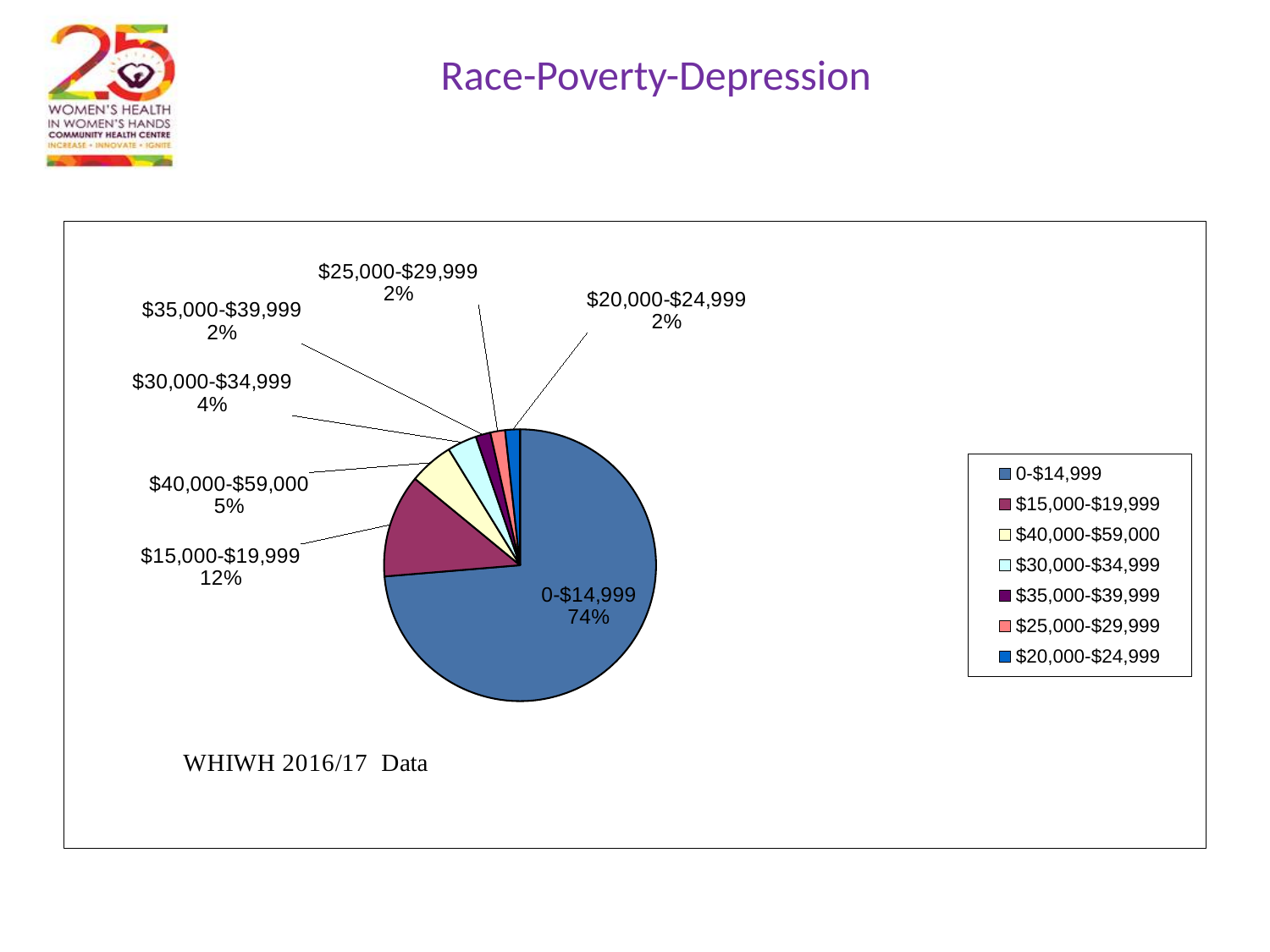
What percentage is shown for the $40,000-$59,000 slice? 5% What percentage is shown for the $15,000-$19,999 slice? 12% What kind of chart is shown on the slide? pie chart Which income category has the largest slice of the pie? 0-$14,999 What percentage is shown for the $20,000-$24,999 slice? 2% Which slice is larger, $40,000-$59,000 or $30,000-$34,999? $40,000-$59,000 How many income categories does the legend list? 7 What share of the pie does the 0-$14,999 slice represent? 74% What data source is noted below the pie chart? WHIWH 2016/17 Data What is the difference in percentage points between the 0-$14,999 slice and the $15,000-$19,999 slice? 62 What percentage is shown for the $30,000-$34,999 slice? 4% What is the title of the slide containing the pie chart? Race-Poverty-Depression